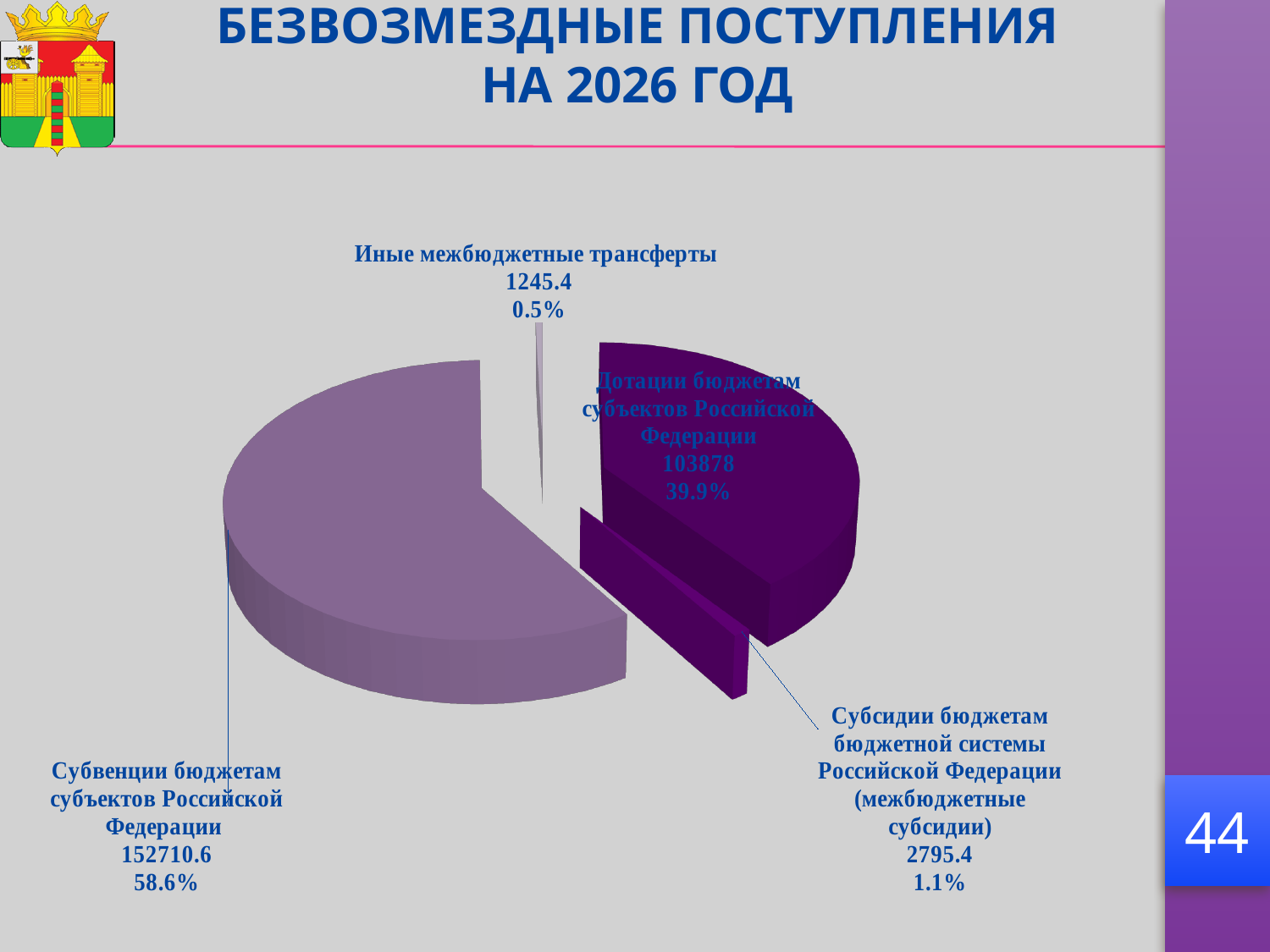
Which category has the smallest slice of the pie? Иные межбюджетные трансферты What is the value shown for Субсидии бюджетам бюджетной системы Российской Федерации (межбюджетные субсидии)? 2795.4 What is the title of the slide containing the chart? БЕЗВОЗМЕЗДНЫЕ ПОСТУПЛЕНИЯ НА 2026 ГОД What is the value shown for Дотации бюджетам субъектов Российской Федерации? 103878 What share of the pie does Дотации бюджетам субъектов Российской Федерации represent? 39.9% How many slices does the pie chart have? 4 What is the value shown for Иные межбюджетные трансферты? 1245.4 Which category has the largest slice of the pie? Субвенции бюджетам субъектов Российской Федерации What share of the pie does Субвенции бюджетам субъектов Российской Федерации represent? 58.6% What is the value shown for Субвенции бюджетам субъектов Российской Федерации? 152710.6 What type of chart is shown on the slide? Pie chart What share of the pie does Иные межбюджетные трансферты represent? 0.5%